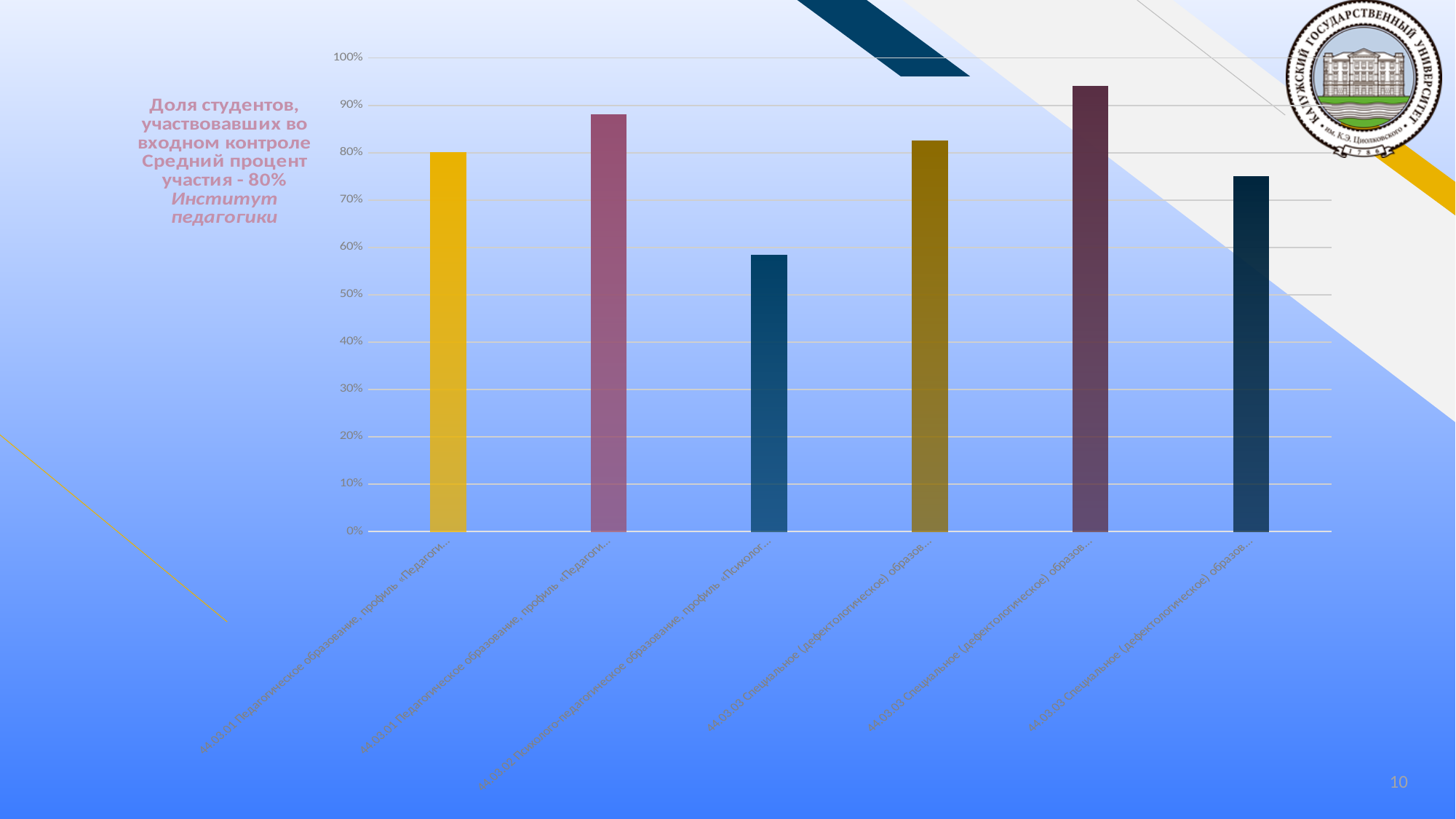
Is the value of the third bar from the left greater or less than 60%? less What kind of chart is shown on the slide? bar chart Is the value of the second bar from the left greater or less than 80%? greater Which bar is the tallest in the chart? the fifth bar from the left Is the value of the third bar from the left greater or less than 50%? greater How many bars does the chart contain? 6 According to the text next to the chart, what is the average participation percentage (средний процент участия)? 80% Which bar is the shortest in the chart? the third bar from the left Which is taller: the second bar from the left or the sixth bar from the left? the second bar from the left Which is taller: the fourth bar from the left or the third bar from the left? the fourth bar from the left